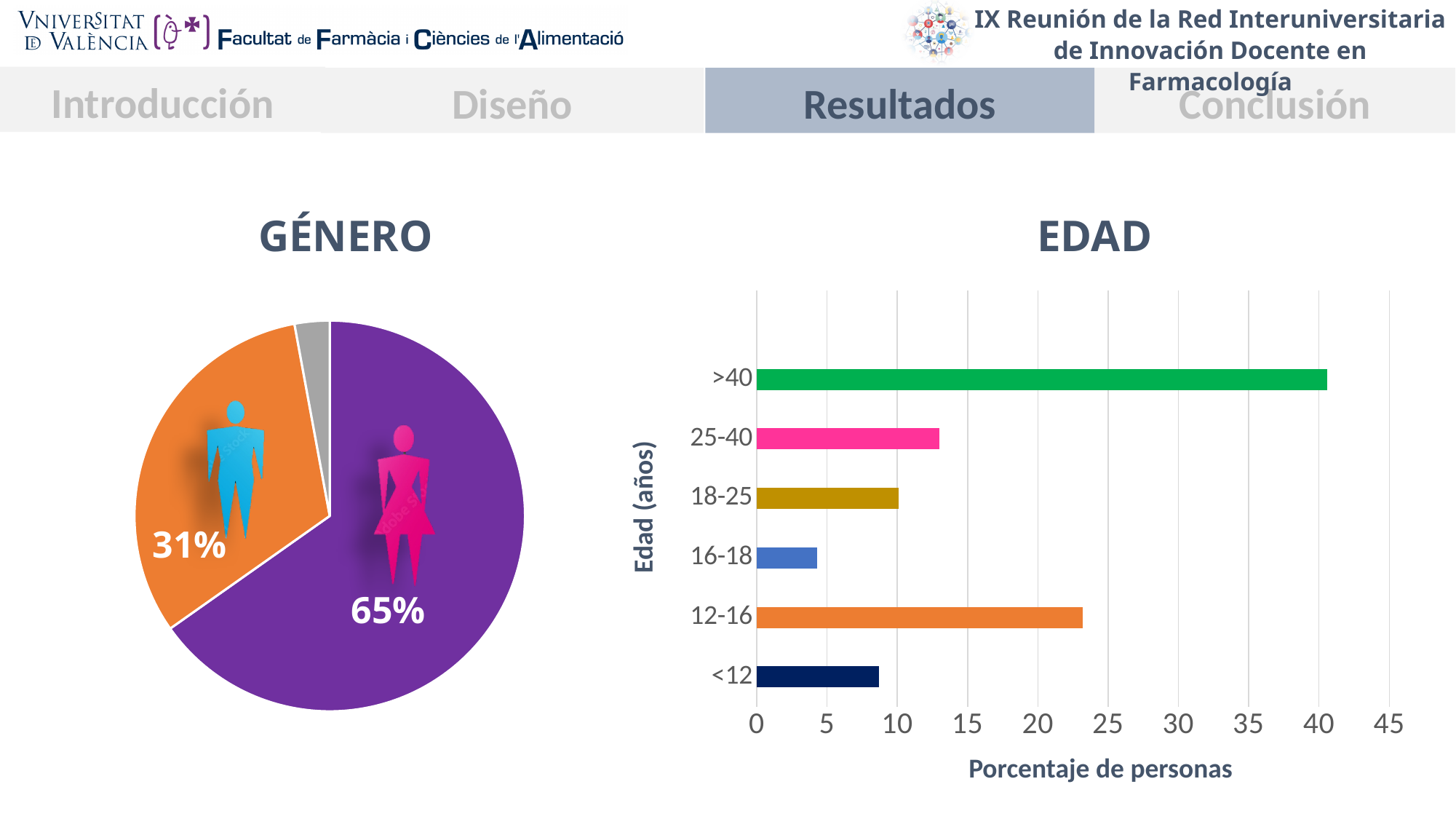
What is the x-axis title of the EDAD bar chart? Porcentaje de personas What kind of chart is the GÉNERO chart? pie chart What kind of chart is the EDAD chart? bar chart In the GÉNERO pie chart, what percentage is shown on the orange slice? 31% In the GÉNERO pie chart, which labelled slice is larger, the purple one or the orange one? the purple one (65%) In the GÉNERO pie chart, what percentage is shown on the purple slice? 65% In the EDAD bar chart, which age category has the highest value? >40 How many slices does the GÉNERO pie chart have? 3 In the EDAD bar chart, which age category has the lowest value? 16-18 In the GÉNERO pie chart, what is the difference between the two labelled slices, 65% and 31%? 34 percentage points In the EDAD bar chart, is the value for 12-16 greater or less than 20? greater How many age categories are shown in the EDAD bar chart? 6